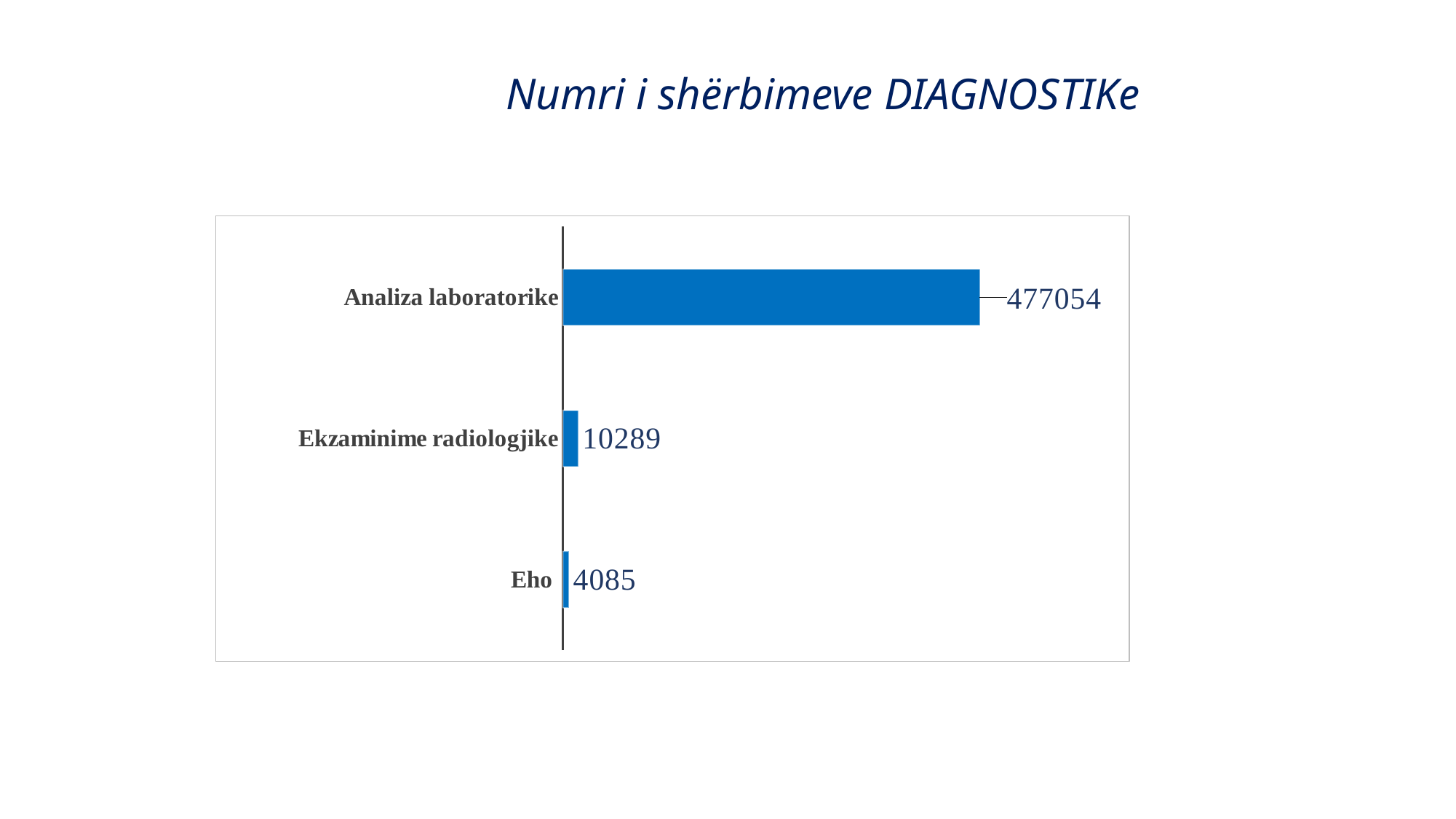
Which is larger, the value for Ekzaminime radiologjike or the value for Eho? Ekzaminime radiologjike What is the value for Analiza laboratorike? 477054 What is the value for Ekzaminime radiologjike? 10289 What is the value for Eho? 4085 Which category has the lowest value? Eho What is the difference between the values for Analiza laboratorike and Ekzaminime radiologjike? 466765 What is the title of the chart? Numri i shërbimeve DIAGNOSTIKe What is the difference between the values for Ekzaminime radiologjike and Eho? 6204 Which category has the highest value? Analiza laboratorike What kind of chart is shown on the slide? Bar chart How many categories are shown in the chart? 3 What colour are the bars in the chart? Blue